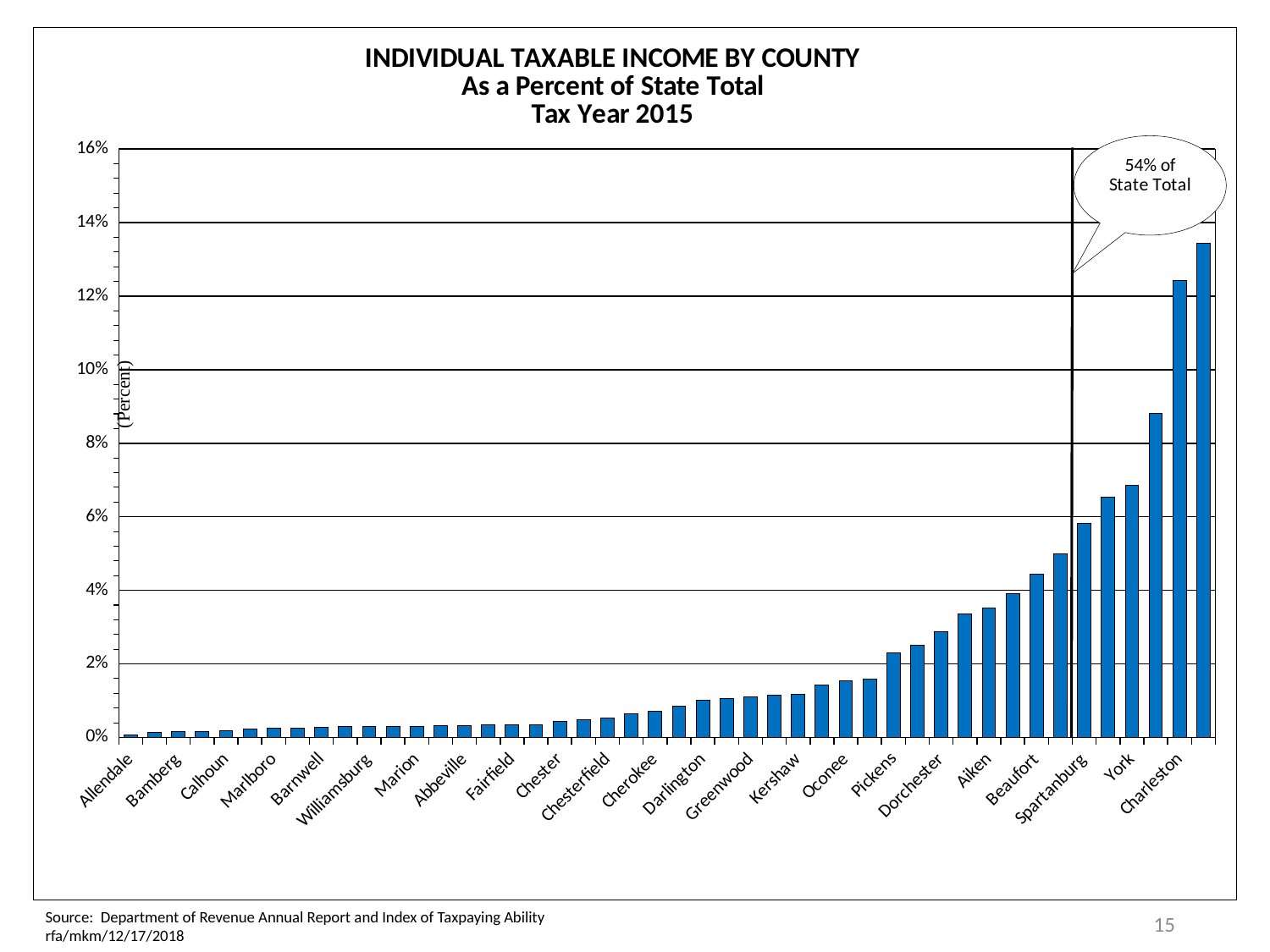
Do the bar values rise or fall moving from left to right along the x axis? rise Which county has the larger value, Charleston or York? Charleston Is the value for Charleston greater or less than 12%? greater Which labeled county has the lowest individual taxable income as a percent of state total? Allendale Is the value for Oconee greater or less than 2%? less Which county has the larger value, Spartanburg or Beaufort? Spartanburg Is the value for Beaufort greater or less than 4%? greater What tax year does the chart title refer to? Tax Year 2015 What share of the state total does the callout say the counties to the right of the vertical line account for? 54% of State Total What kind of chart is shown on the slide? bar chart